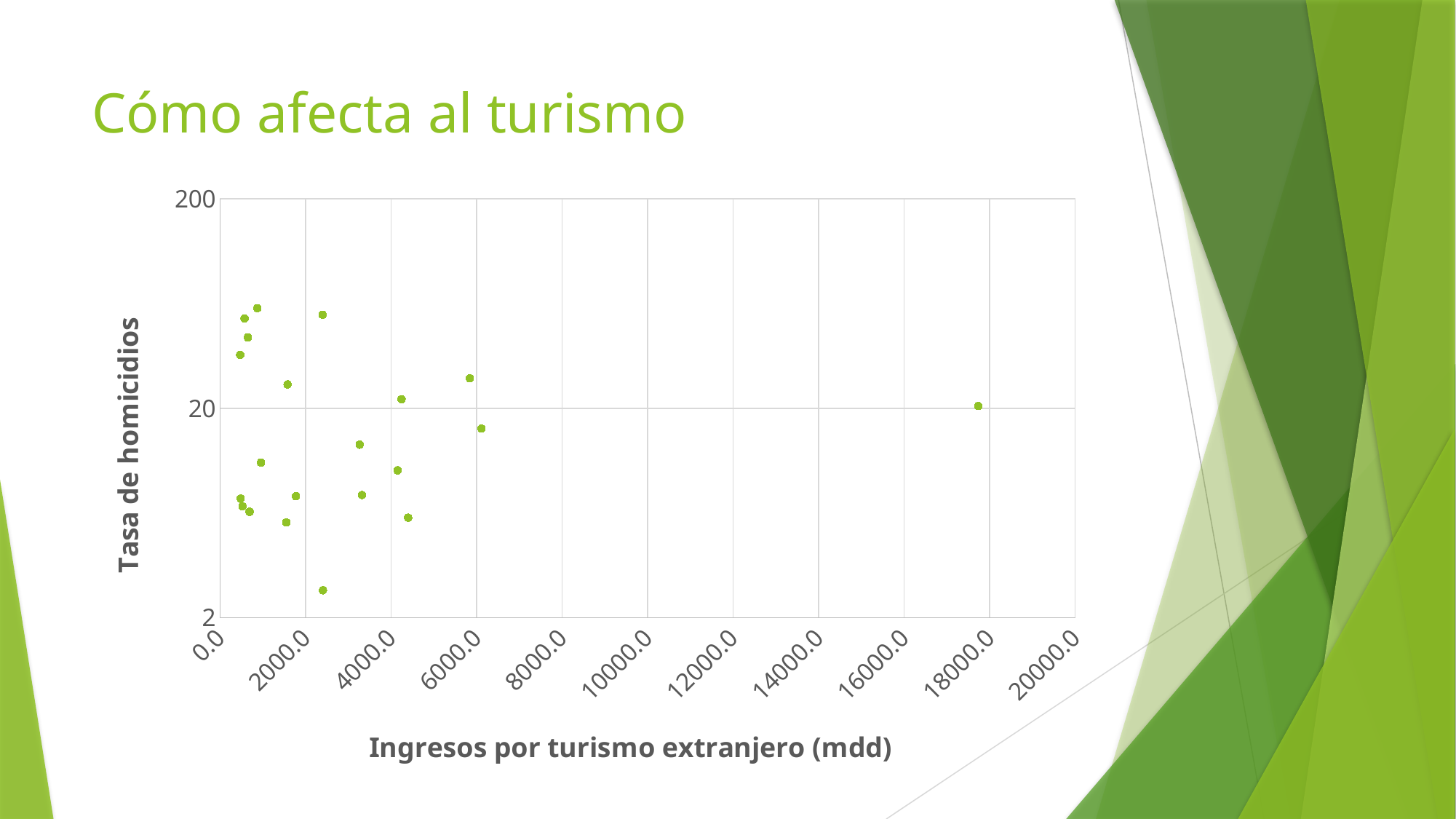
Is the homicide rate of the lowest point on the chart greater or less than 20? less Are there more points with tourism income below 8000 or above 8000? below 8000 Is the tourism income of the rightmost point on the chart greater or less than 20000? less What is the label of the horizontal axis of the chart? Ingresos por turismo extranjero (mdd) What kind of chart is shown on the slide? scatter chart Is the homicide rate of the highest point on the chart greater or less than 20? greater What is the title of the chart on the slide? Cómo afecta al turismo